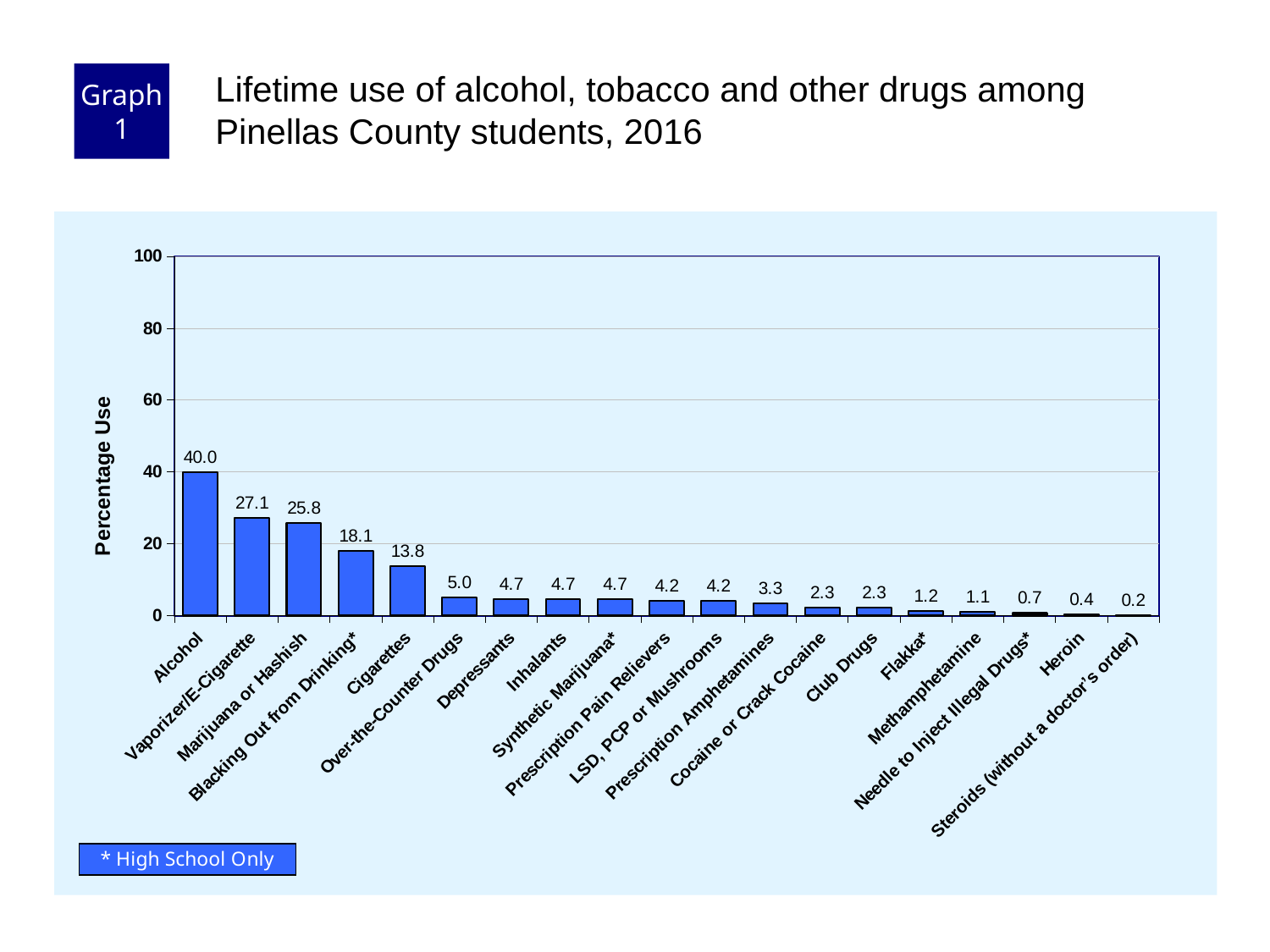
Which has a higher percentage use, Blacking Out from Drinking* or Cigarettes? Blacking Out from Drinking* What is the percentage use for Alcohol? 40.0 Which category has the lowest percentage use? Steroids (without a doctor's order) How many categories are shown on the chart? 19 What is the percentage use for Cigarettes? 13.8 Do the values rise or fall moving from left to right along the x axis? Fall What is the percentage use for Vaporizer/E-Cigarette? 27.1 Which category has the highest percentage use? Alcohol What is the percentage use for Heroin? 0.4 What kind of chart is shown on the slide? Bar chart What is the label of the y axis? Percentage Use What is the difference in percentage use between Alcohol and Marijuana or Hashish? 14.2